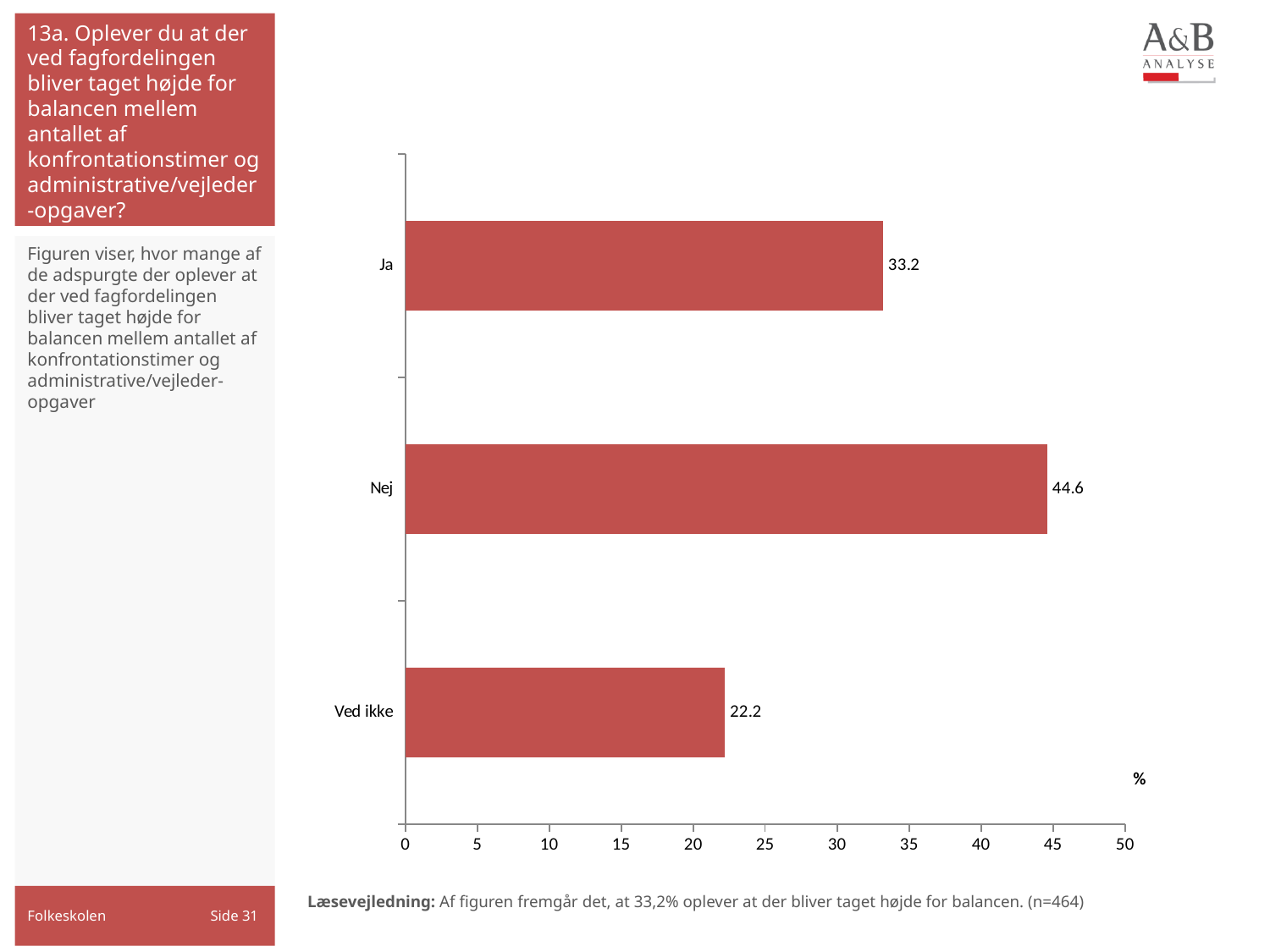
How many categories are shown in the chart? 3 What kind of chart is shown on the slide? Bar chart Which category has the highest value? Nej What is the value for "Ved ikke"? 22.2 What is the difference between the values for "Nej" and "Ja"? 11.4 What is the value for "Ja"? 33.2 Which is larger, the value for "Ja" or the value for "Ved ikke"? Ja What is the maximum value shown on the x axis? 50 What is the difference between the values for "Ja" and "Ved ikke"? 11.0 Which category has the lowest value? Ved ikke What is the value for "Nej"? 44.6 Is the value for "Nej" greater or less than 40? greater